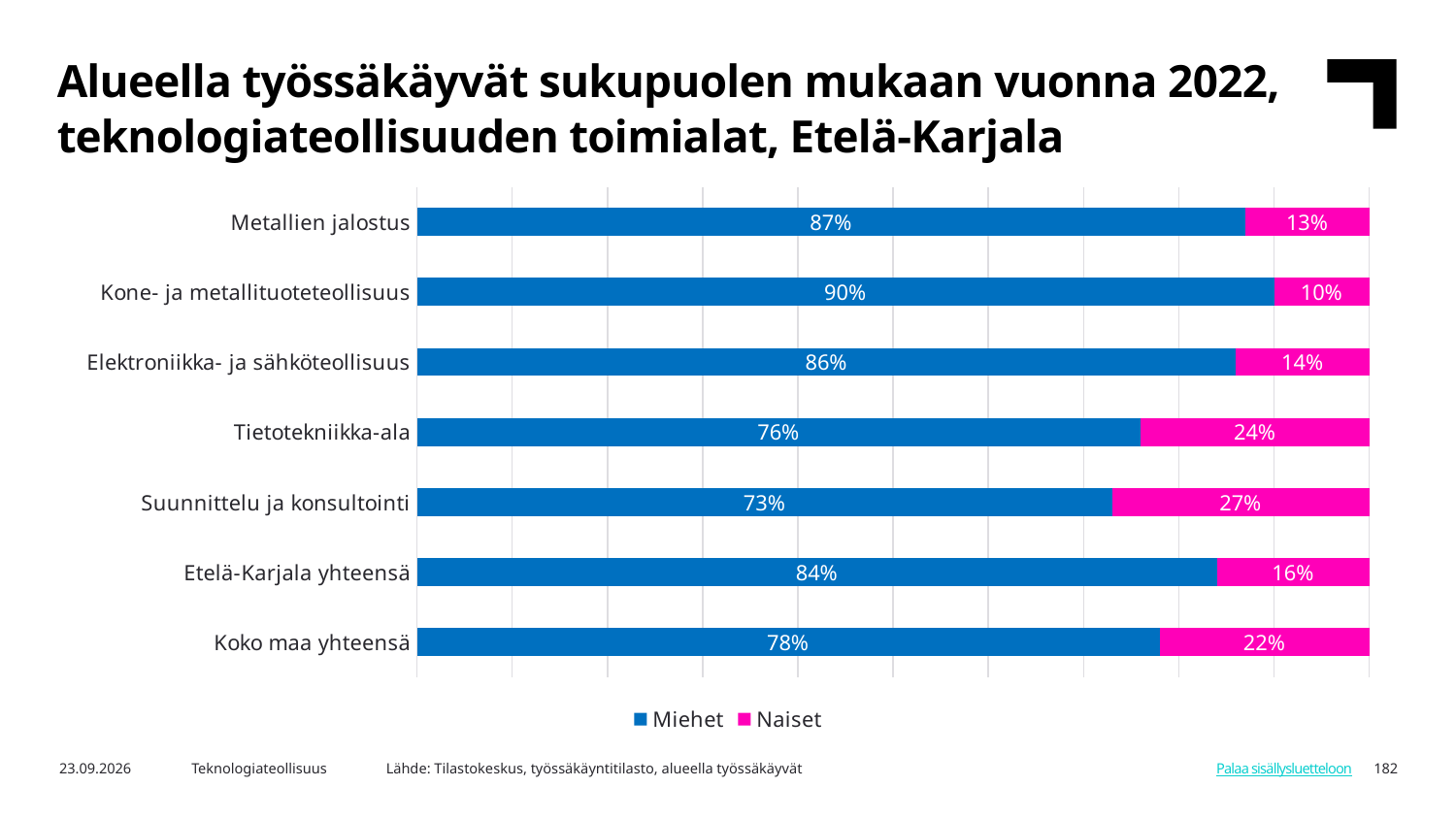
What kind of chart is shown on the slide? Stacked bar chart What is the Naiset share for Koko maa yhteensä? 22% What is the Naiset share for Suunnittelu ja konsultointi? 27% Which category has the lowest Naiset share? Kone- ja metallituoteteollisuus Which has a larger Naiset share, Elektroniikka- ja sähköteollisuus or Etelä-Karjala yhteensä? Etelä-Karjala yhteensä How many categories are shown on the chart? 7 What is the Miehet share for Kone- ja metallituoteteollisuus? 90% Which category has the lowest Miehet share? Suunnittelu ja konsultointi What is the difference in percentage points between the Miehet share for Metallien jalostus and for Tietotekniikka-ala? 11 What is the Miehet share for Etelä-Karjala yhteensä? 84% How many series does the legend list? 2 Which category has the highest Naiset share? Suunnittelu ja konsultointi